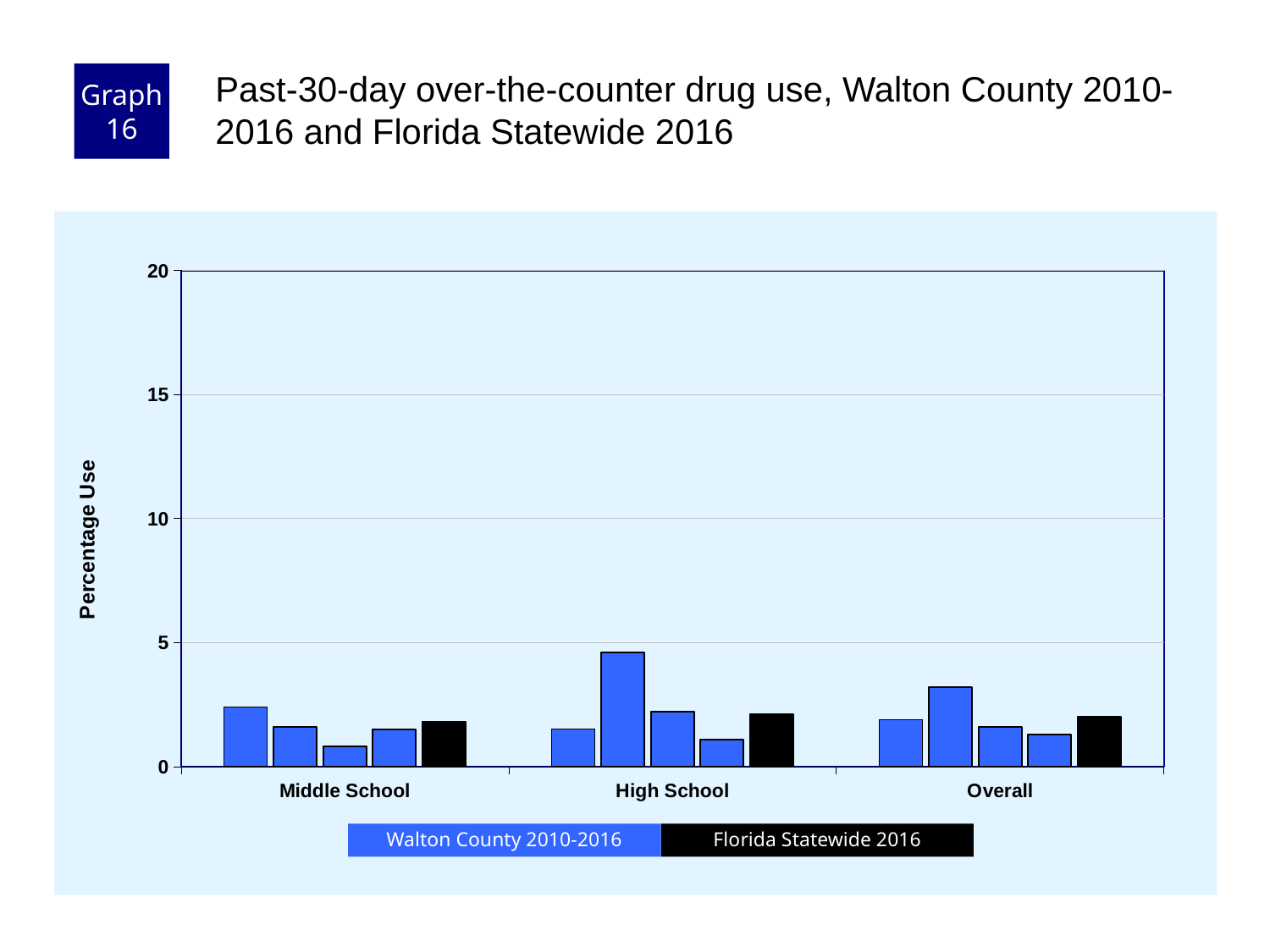
How many categories are shown on the x axis? 3 Which is larger: the tallest Walton County 2010-2016 bar for High School or the tallest Walton County 2010-2016 bar for Middle School? High School Which category contains the tallest bar on the chart? High School Is the Florida Statewide 2016 value for Overall greater or less than 10? less Which category contains the shortest bar on the chart? Middle School What is the label on the y axis? Percentage Use What kind of chart is shown on the slide? bar chart Is the tallest Walton County 2010-2016 bar for High School greater or less than 5? less Is the Florida Statewide 2016 value for High School greater or less than 5? less How many bars are plotted for the High School category? 5 How many series does the legend list? 2 What colour are the Florida Statewide 2016 bars? black